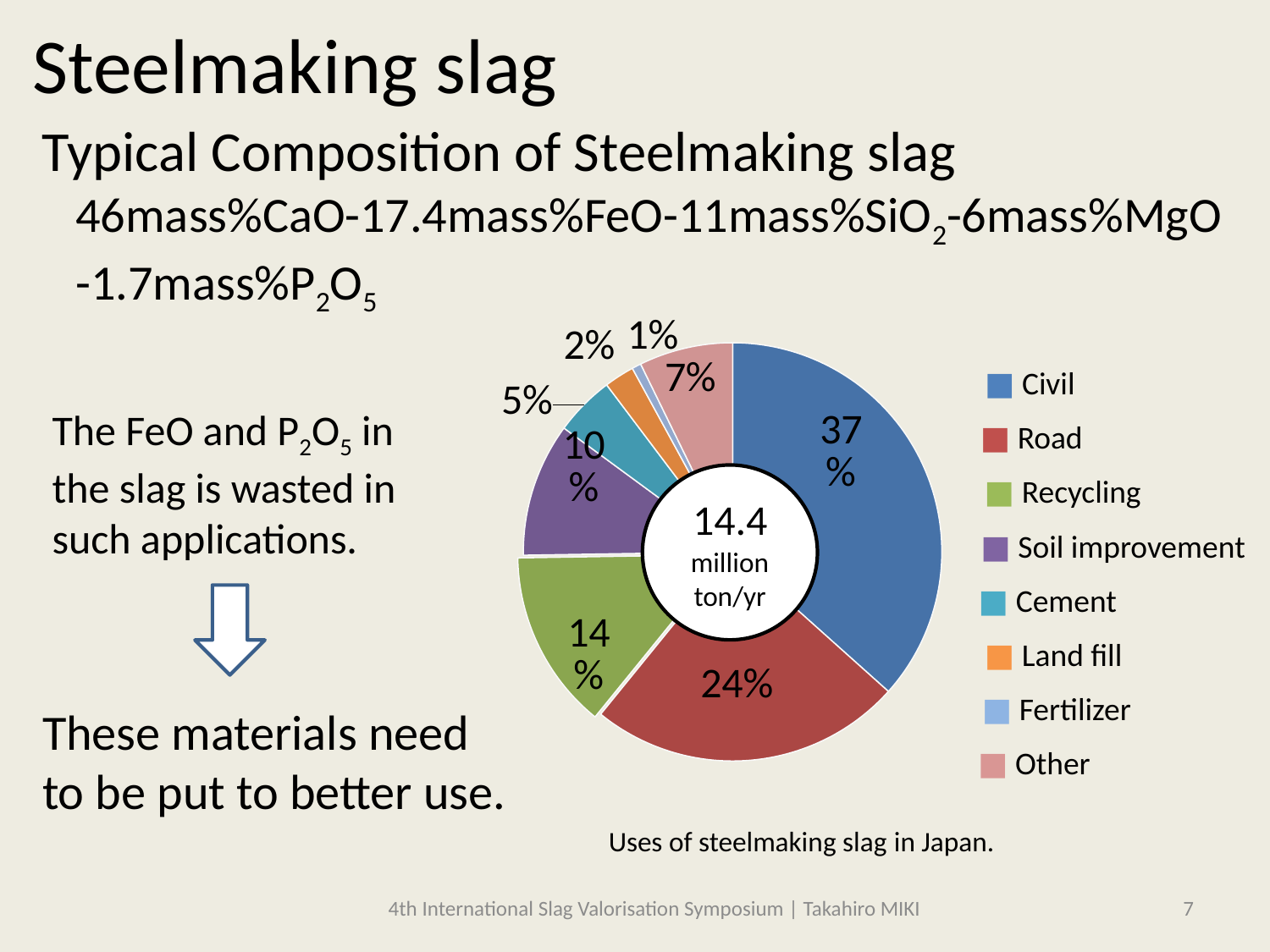
What share of the pie is Cement? 5% What total quantity is printed in the centre of the pie chart? 14.4 million ton/yr What share of steelmaking slag use in Japan goes to Civil? 37% What kind of chart is shown on the slide? pie chart What share of the pie is Recycling? 14% How many percentage points larger is the Civil share than the Road share? 13 Which use category has the smallest share of the pie? Fertilizer What share of steelmaking slag use in Japan goes to Road? 24% Which has a larger share of the pie, Other or Cement? Other How many categories does the pie chart legend list? 8 Which use category has the largest share of the pie? Civil What share of the pie is Soil improvement? 10%